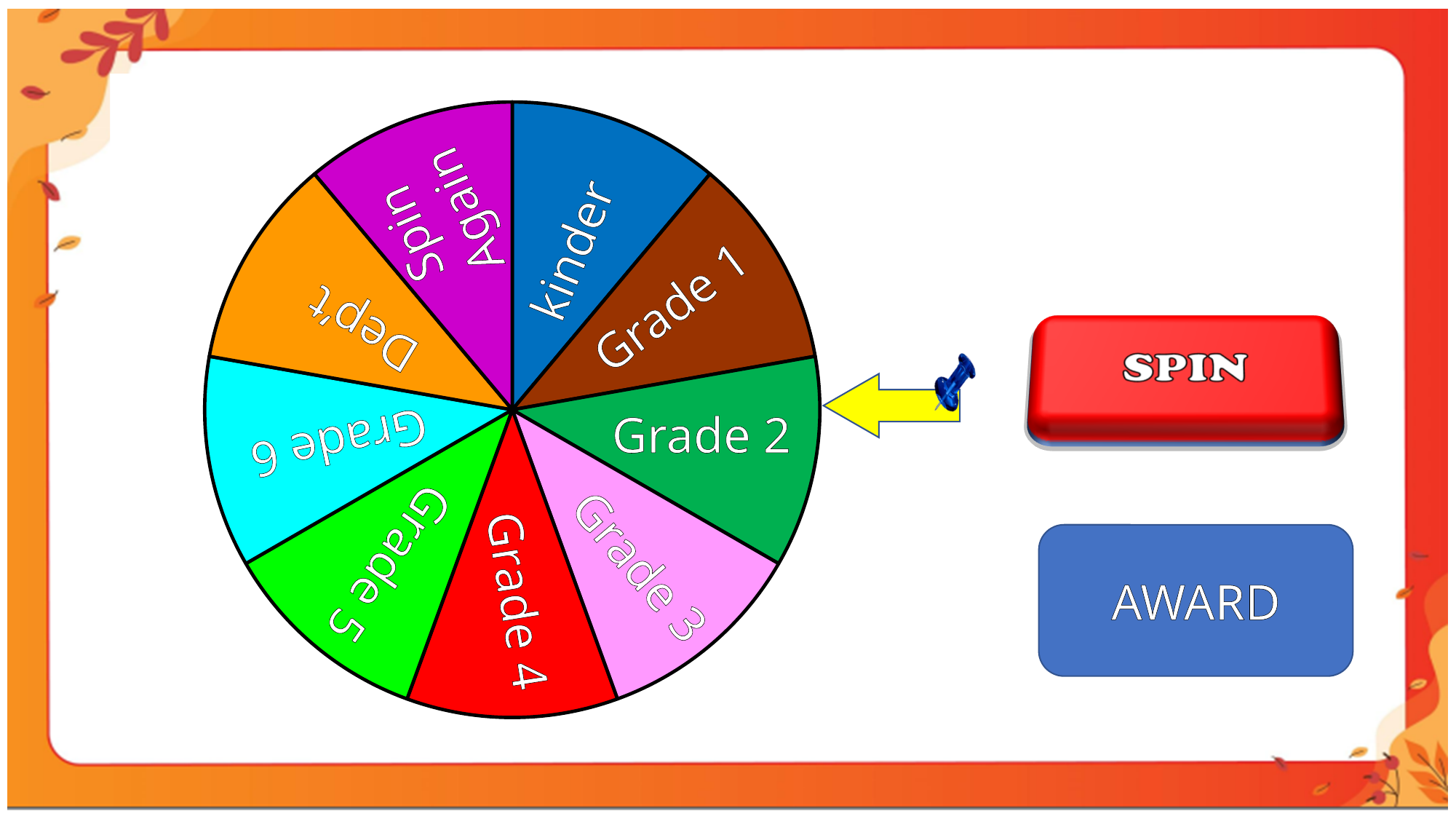
Which slice of the wheel is coloured cyan? Grade 6 Which slice of the wheel is coloured blue? kinder Which slice sits between the kinder slice and the Grade 2 slice on the wheel? Grade 1 What colour is the Grade 4 slice of the wheel? red What kind of chart is the wheel on the slide? pie chart Which slice of the wheel is the yellow arrow pointing to? Grade 2 How many slices does the wheel have? 9 Which slice of the wheel is labelled with a non-grade option that lets the player spin again? Spin Again Which slice sits between the Grade 6 slice and the Spin Again slice on the wheel? Dep't Which slice of the wheel is coloured pink? Grade 3